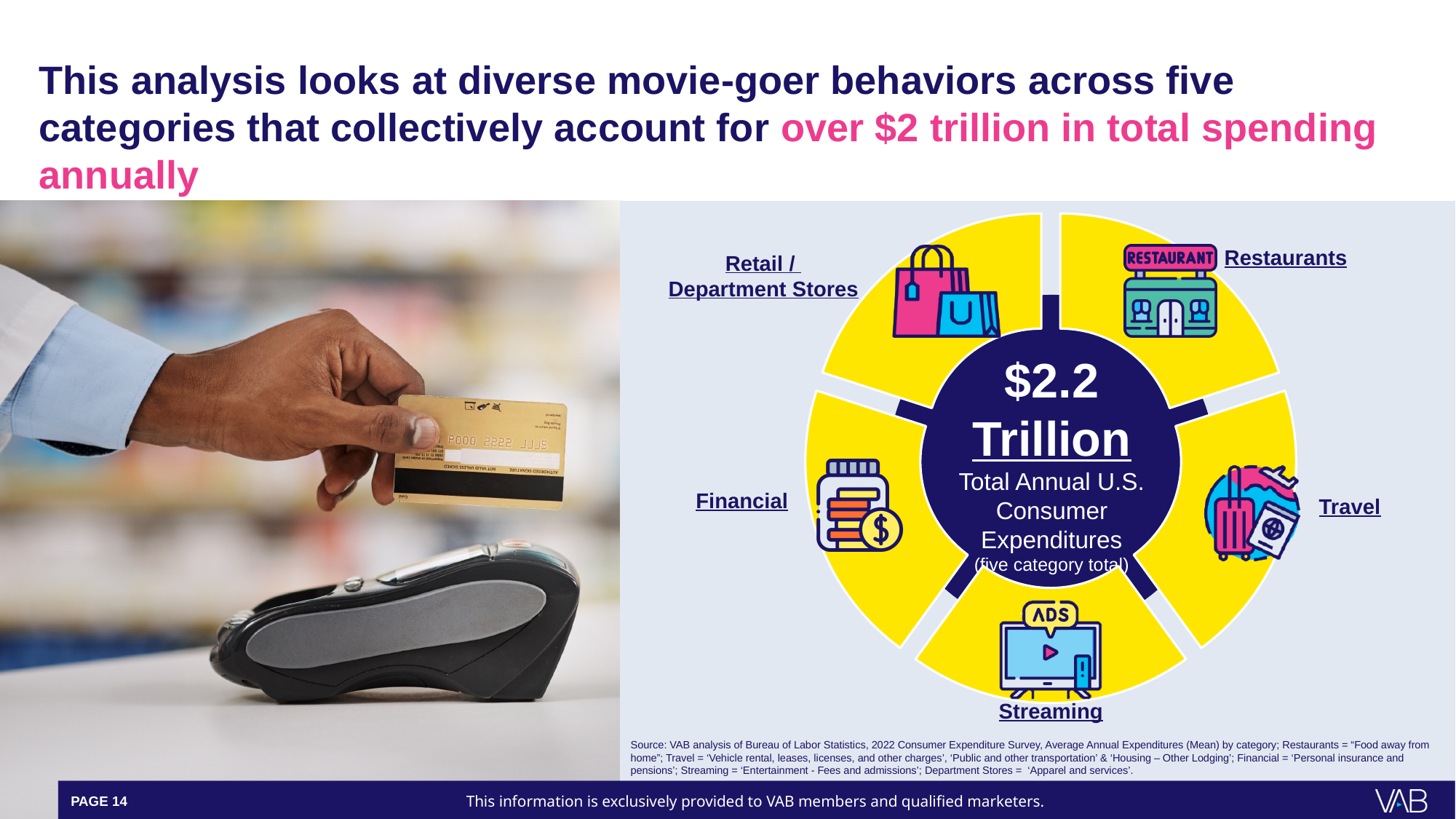
Which category label appears at the bottom of the ring diagram, below the ADS/TV icon? Streaming What total value is printed in the center of the ring diagram? $2.2 Trillion What does the center of the ring diagram say the $2.2 Trillion figure represents? Total Annual U.S. Consumer Expenditures (five category total) Name the five categories shown around the ring diagram. Retail / Department Stores, Restaurants, Travel, Streaming, Financial What kind of chart is shown on the right side of the slide? Donut (ring) chart How many categories are shown as segments in the ring diagram? 5 Which category is shown in the segment with the shopping bags icon? Retail / Department Stores